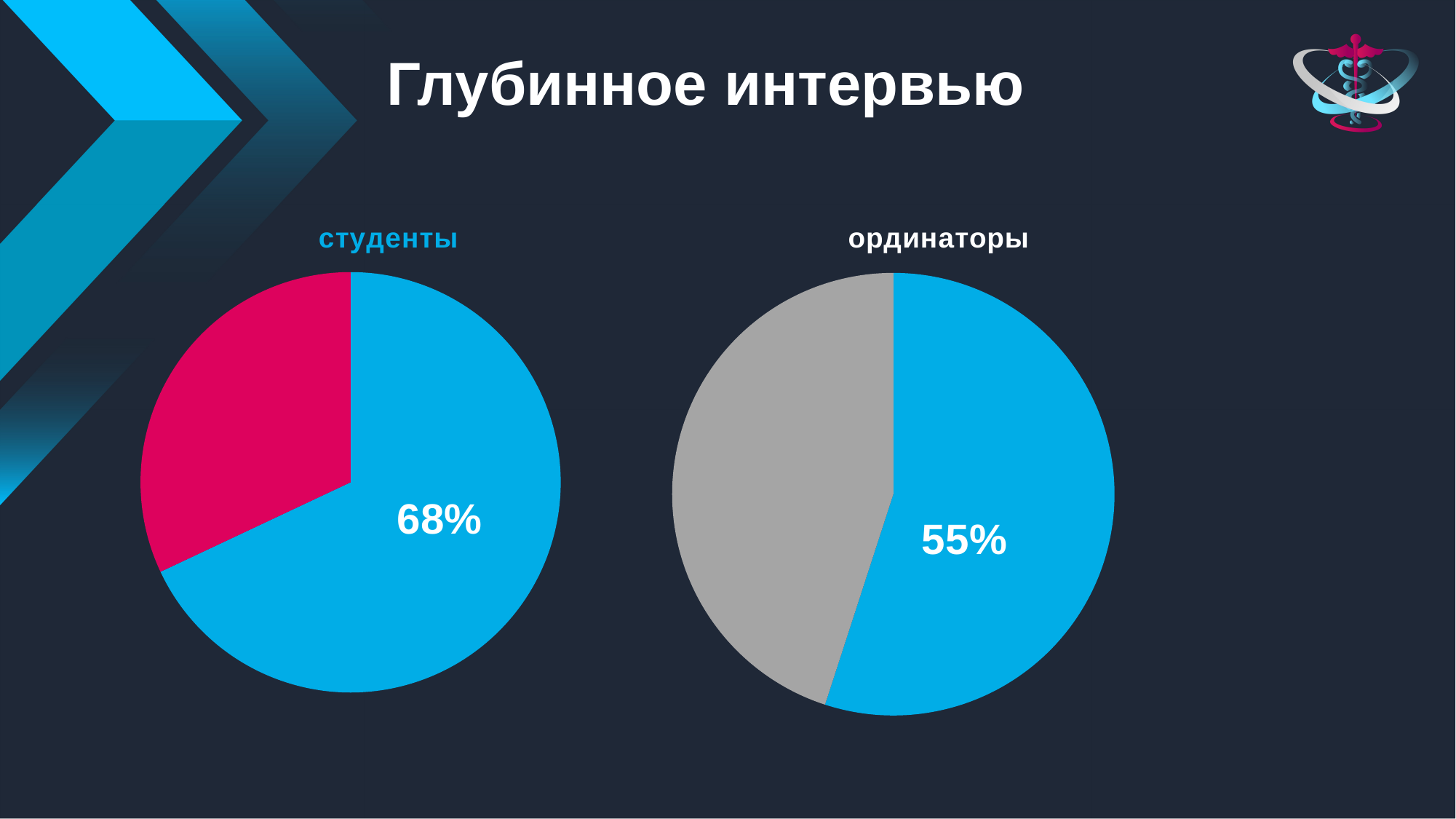
What is the difference between the labelled blue slice in the "студенты" pie chart and the labelled blue slice in the "ординаторы" pie chart? 13 percentage points In the "ординаторы" pie chart, which slice is larger, the blue one or the grey one? the blue one In the "студенты" pie chart, which slice is larger, the blue one or the pink one? the blue one What is the title of the slide containing the two pie charts? Глубинное интервью How many slices does the "ординаторы" pie chart have? 2 What kind of chart is shown under the heading "студенты"? pie chart How many slices does the "студенты" pie chart have? 2 How many pie charts are on the slide? 2 In the "ординаторы" pie chart, what value is printed on the blue slice? 55% What kind of chart is shown under the heading "ординаторы"? pie chart Which pie chart has the larger labelled blue slice, "студенты" or "ординаторы"? студенты In the "студенты" pie chart, what value is printed on the blue slice? 68%